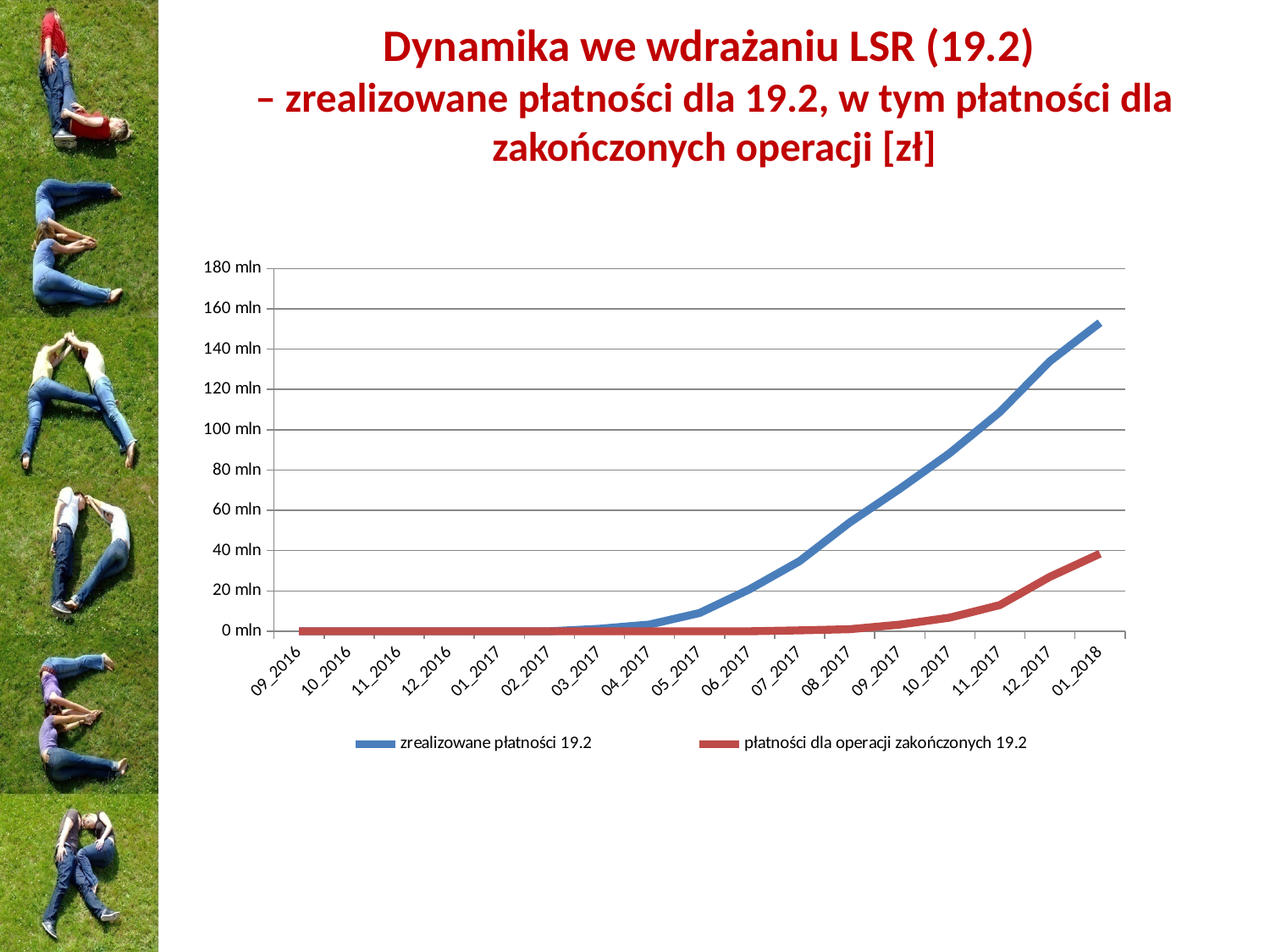
How many months are shown on the x axis? 17 Is the value for 'płatności dla operacji zakończonych 19.2' in 11_2017 greater or less than 20 mln? less How many series does the legend list? 2 Is the value for 'zrealizowane płatności 19.2' in 01_2018 greater or less than 140 mln? greater Which month has the highest value for 'płatności dla operacji zakończonych 19.2'? 01_2018 What colour is the line for 'płatności dla operacji zakończonych 19.2'? red In 01_2018, which series has the larger value: 'zrealizowane płatności 19.2' or 'płatności dla operacji zakończonych 19.2'? zrealizowane płatności 19.2 Is the value for 'zrealizowane płatności 19.2' in 11_2017 greater or less than 100 mln? greater Which month has the highest value for 'zrealizowane płatności 19.2'? 01_2018 Do the values for 'zrealizowane płatności 19.2' rise or fall from 09_2016 to 01_2018? rise What kind of chart is shown on the slide? line chart